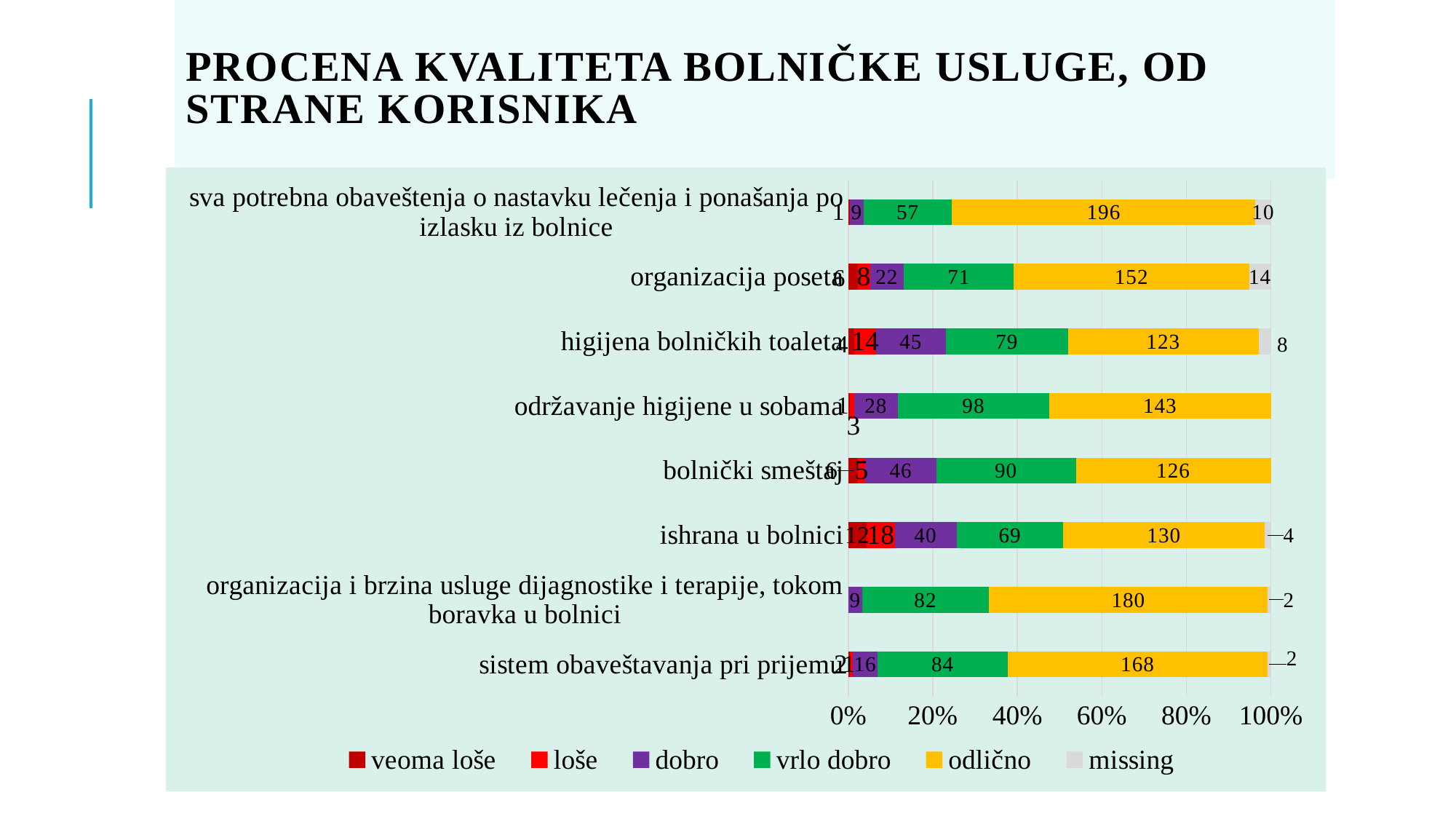
Which category has the highest 'odlično' value? sva potrebna obaveštenja o nastavku lečenja i ponašanja po izlasku iz bolnice What is the 'missing' value for 'organizacija poseta'? 14 How many series does the legend list? 6 What is the 'odlično' value for 'sva potrebna obaveštenja o nastavku lečenja i ponašanja po izlasku iz bolnice'? 196 What is the 'vrlo dobro' value for 'održavanje higijene u sobama'? 98 What is the difference between the 'odlično' values for 'organizacija poseta' and 'higijena bolničkih toaleta'? 29 What is the 'vrlo dobro' value for 'sistem obaveštavanja pri prijemu'? 84 Which has the larger 'vrlo dobro' value, 'bolnički smeštaj' or 'ishrana u bolnici'? bolnički smeštaj What kind of chart is shown on the slide? bar chart What is the 'dobro' value for 'higijena bolničkih toaleta'? 45 How many categories are plotted on the chart? 8 What colour represents the 'odlično' series in the legend? yellow